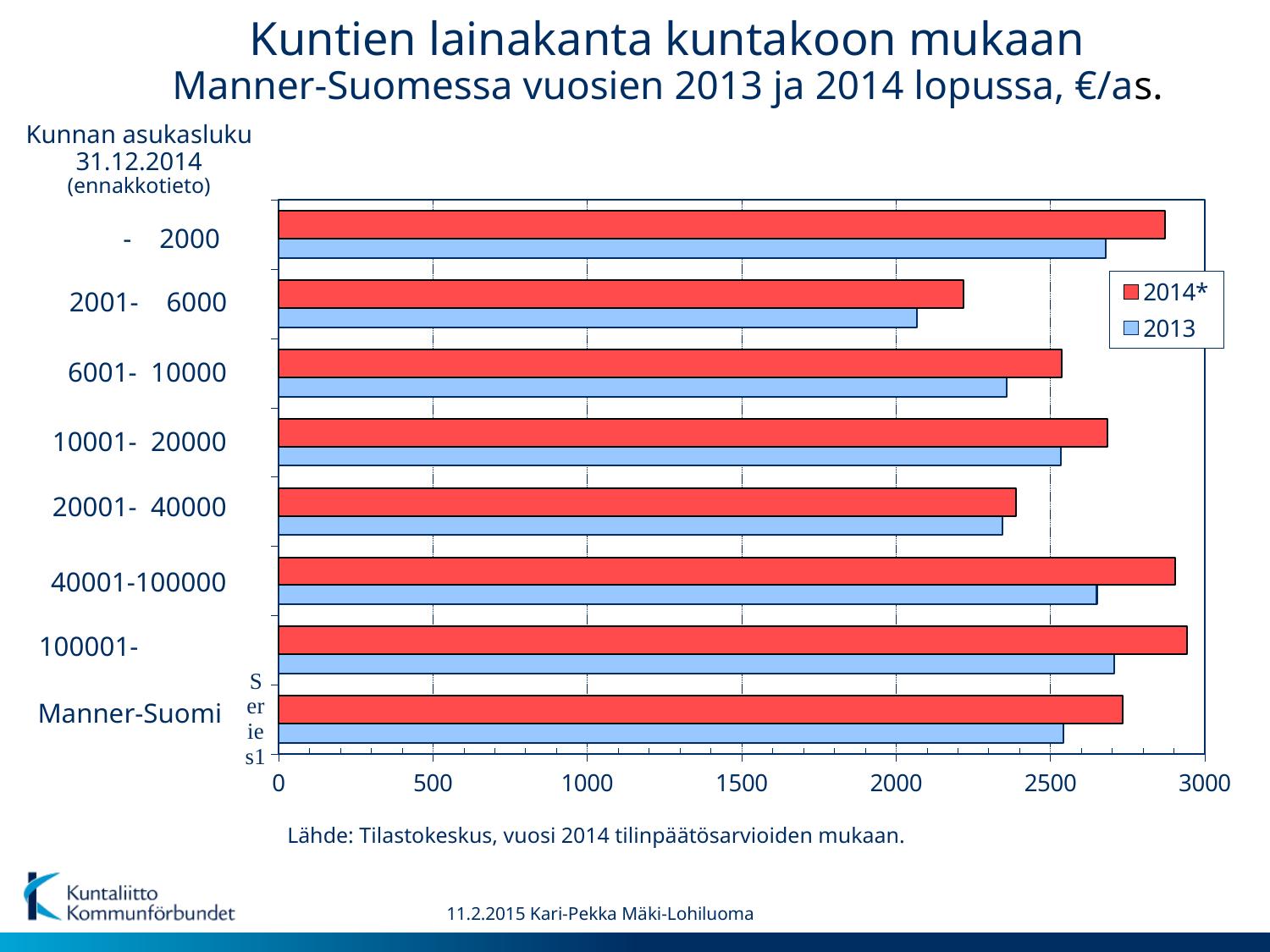
Is the 2013 value for the 6001- 10000 category greater or less than 2500? less Which category has the lowest 2013 value? 2001- 6000 Which colour represents the 2013 series in the legend? blue How many population-size categories are plotted on the chart? 8 Is the 2014* value for the 2001- 6000 category greater or less than 2500? less Is the 2014* value for the - 2000 category greater or less than 2500? greater What kind of chart is shown on the slide? bar chart Which is larger: the 2014* value for - 2000 or the 2014* value for 2001- 6000? - 2000 Which category has the lowest 2014* value? 2001- 6000 How many series does the legend list? 2 For the - 2000 category, which is larger: the 2014* value or the 2013 value? 2014*